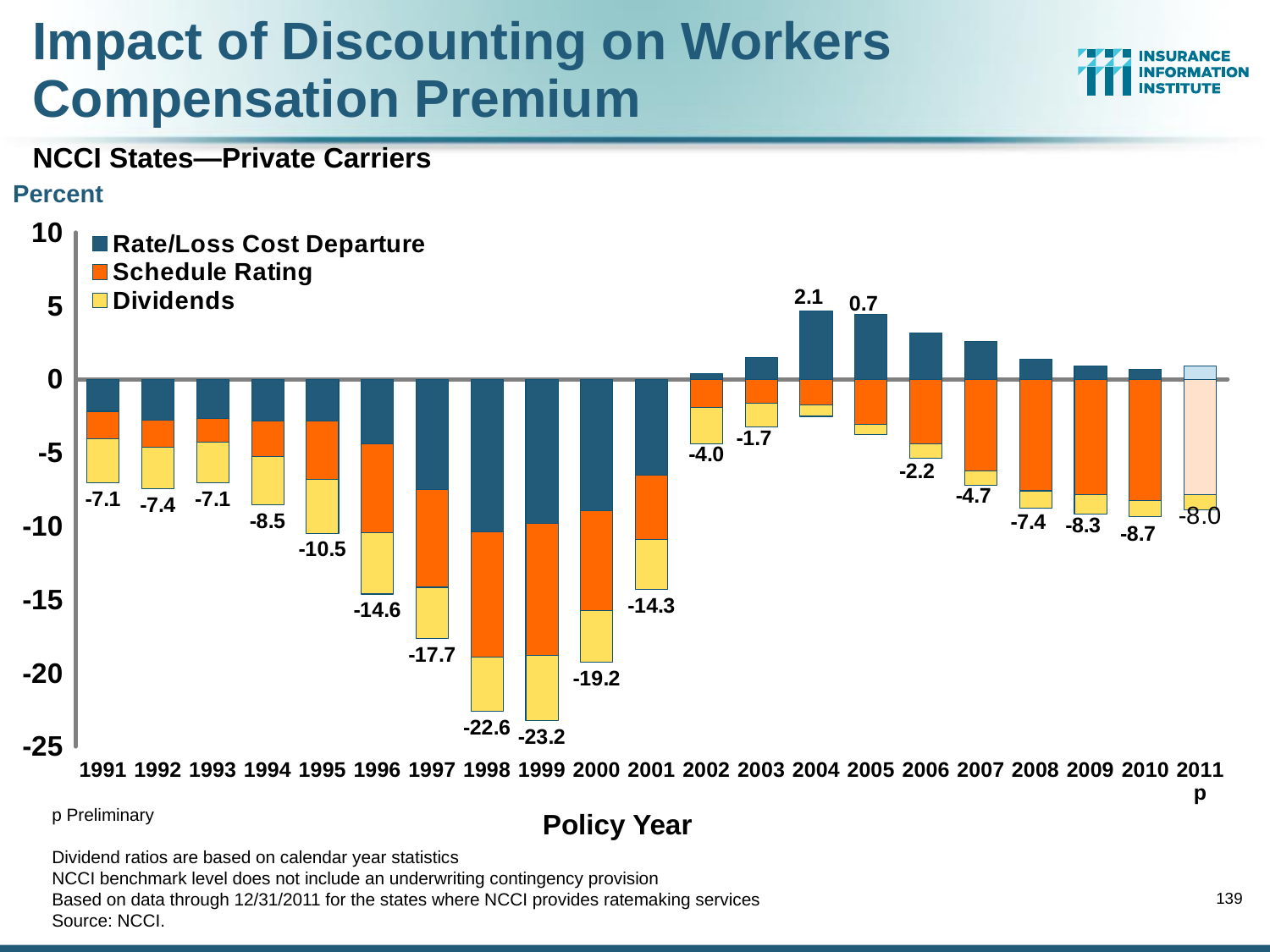
Which policy year has the highest (most positive) net total label? 2004 What is the net total labeled for policy year 1999? -23.2 What is the net total labeled for policy year 2011p? -8.0 Which policy year has the lowest (most negative) net total label? 1999 What is the net total labeled for policy year 2004? 2.1 How many policy years are shown on the x axis? 21 What is the difference between the net total labels for 1998 and 1999? 0.6 What kind of chart is shown on the slide? Stacked bar chart Do the net total labels rise or fall from 1991 to 1999? Fall Which series in the legend is shown in yellow? Dividends How many series does the legend list? 3 Which policy year has a more negative net total label, 2000 or 2001? 2000